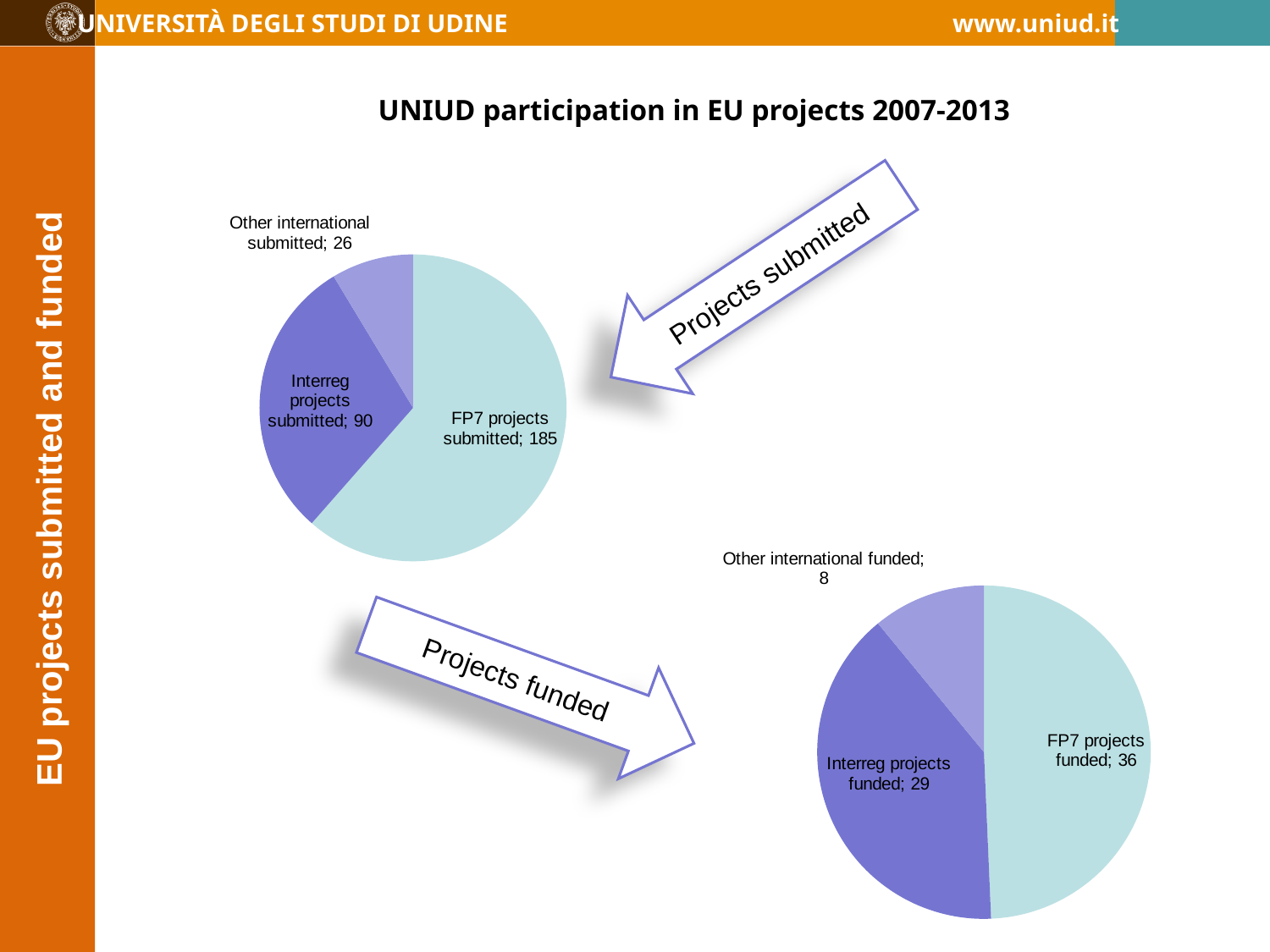
In the 'Projects submitted' pie chart, how many FP7 projects were submitted? 185 In the 'Projects funded' pie chart, how many Other international projects were funded? 8 How many slices does the 'Projects submitted' pie chart have? 3 In the 'Projects submitted' pie chart, how many Interreg projects were submitted? 90 What type of chart is used for 'Projects funded'? Pie chart In the 'Projects submitted' pie chart, what is the difference between FP7 projects submitted and Interreg projects submitted? 95 In the 'Projects submitted' pie chart, which category has the largest slice? FP7 projects submitted What is the total number of projects submitted across all three categories in the 'Projects submitted' pie chart? 301 In the 'Projects funded' pie chart, which category has the smallest slice? Other international funded In the 'Projects funded' pie chart, how many Interreg projects were funded? 29 In the 'Projects funded' pie chart, which is larger: FP7 projects funded or Interreg projects funded? FP7 projects funded In the 'Projects funded' pie chart, what is the difference between FP7 projects funded and Interreg projects funded? 7